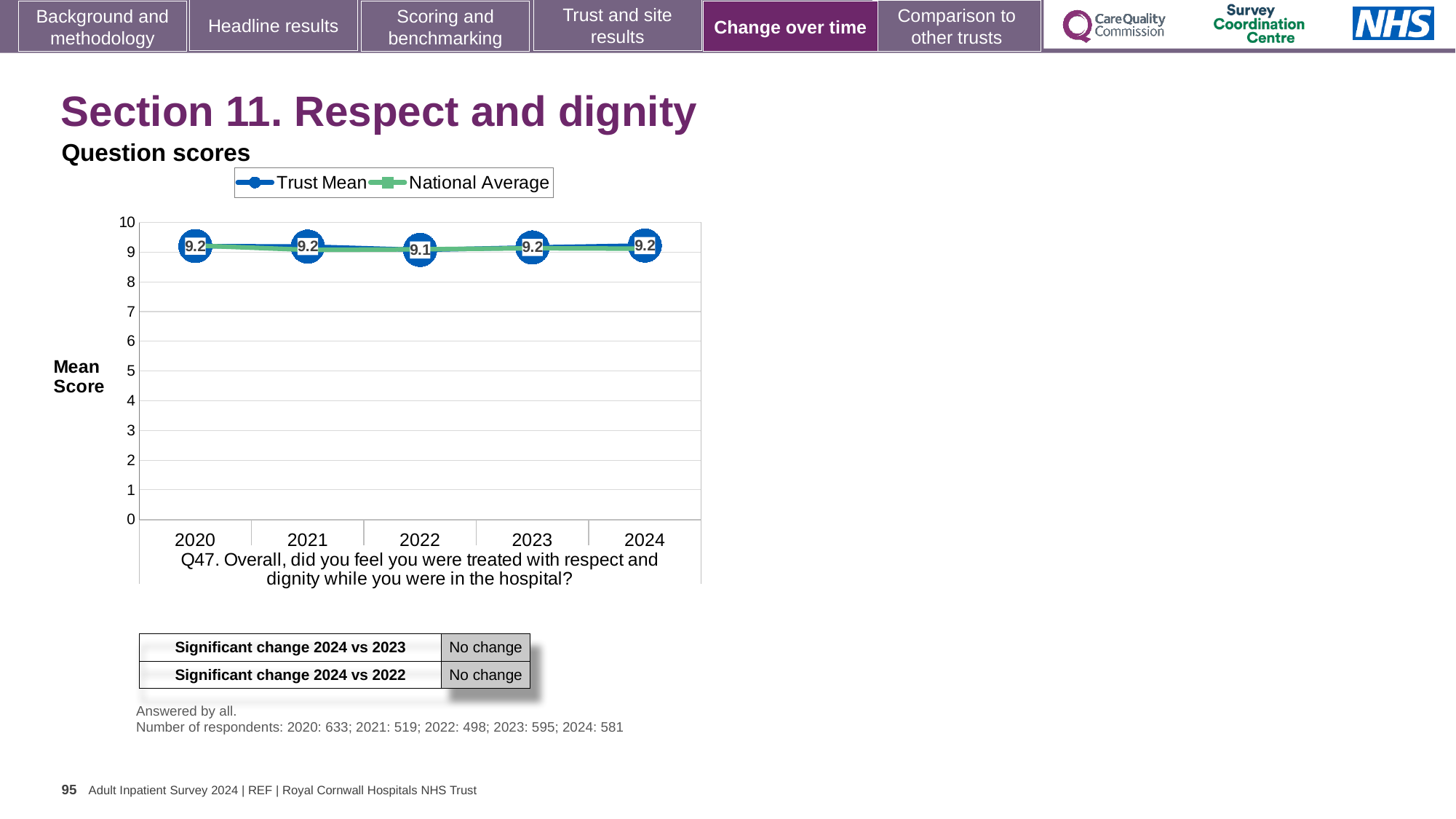
What is the label of the y axis? Mean Score What is the Trust Mean score for 2022? 9.1 Is the National Average for 2024 greater or less than 7? greater What kind of chart is shown? Line chart What is the Trust Mean score for 2024? 9.2 Which series is shown in blue in the legend? Trust Mean What is the Trust Mean score for 2020? 9.2 How many years are plotted on the x axis? 5 In which year is the Trust Mean score lowest? 2022 What is the difference between the Trust Mean score in 2021 and in 2022? 0.1 How many series does the legend list? 2 Is the Trust Mean score for 2023 greater or less than 8? greater